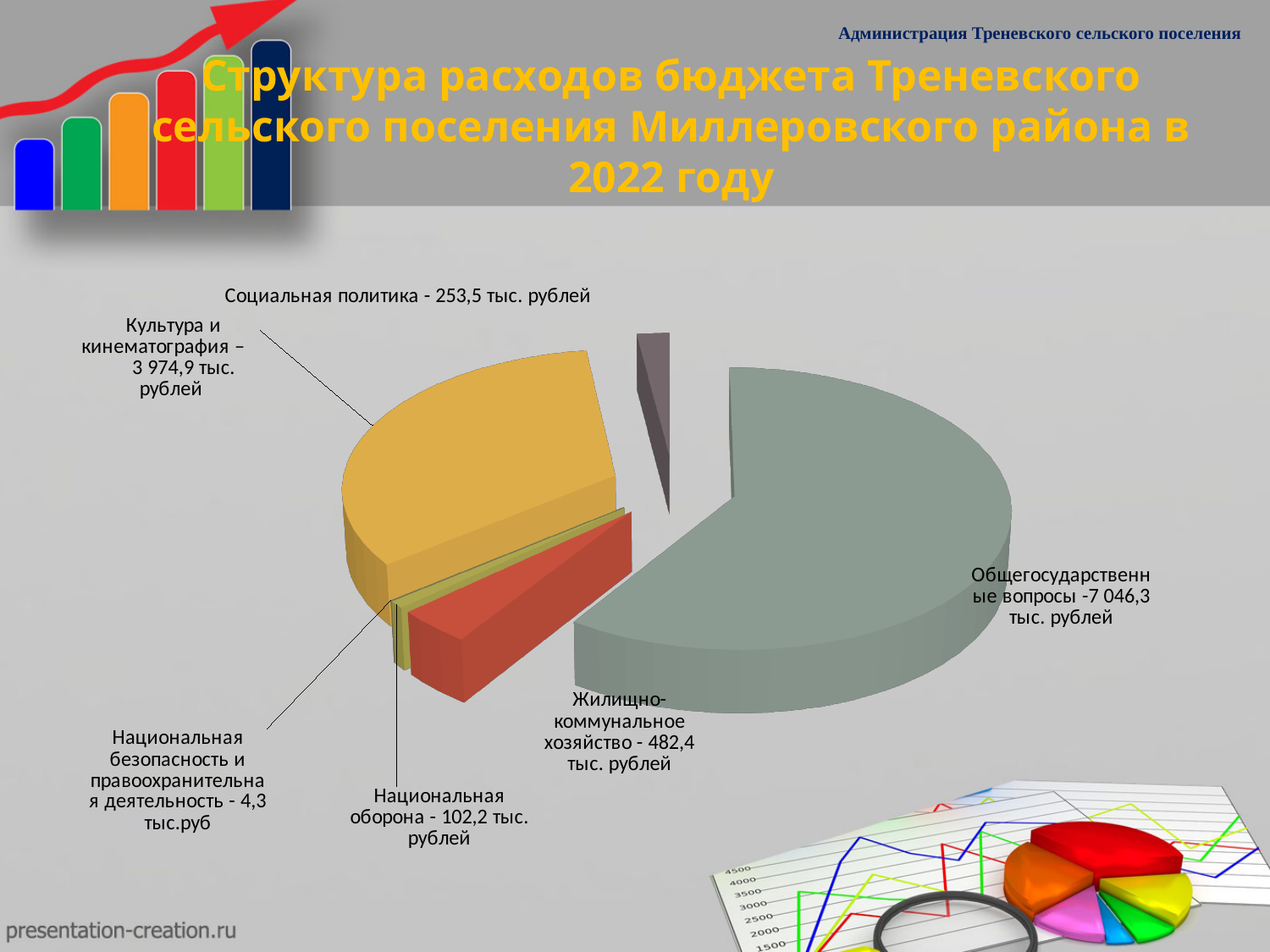
Which is larger: Социальная политика or Жилищно-коммунальное хозяйство? Жилищно-коммунальное хозяйство What is the value for Общегосударственные вопросы? 7 046,3 тыс. рублей What is the difference between Общегосударственные вопросы and Культура и кинематография? 3 071,4 тыс. рублей What is the value for Национальная безопасность и правоохранительная деятельность? 4,3 тыс.руб What is the value for Культура и кинематография? 3 974,9 тыс. рублей How many categories (slices) does the pie chart show? 6 Which category has the largest share of expenditures? Общегосударственные вопросы Which category has the smallest share of expenditures? Национальная безопасность и правоохранительная деятельность What year does the chart title refer to? 2022 What kind of chart is shown on the slide? Pie chart What is the value for Национальная оборона? 102,2 тыс. рублей What is the value for Жилищно-коммунальное хозяйство? 482,4 тыс. рублей